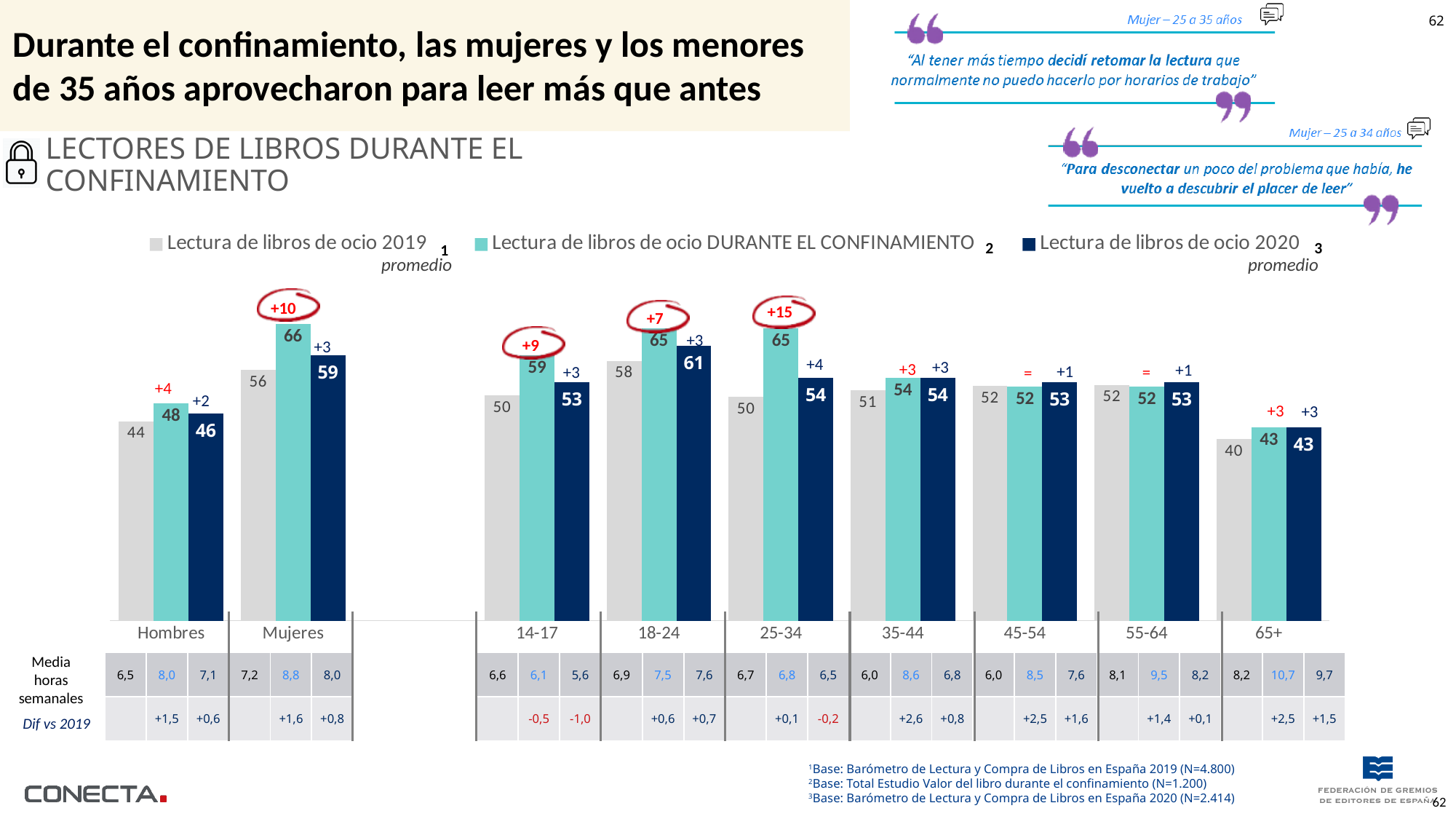
How many categories are shown on the x axis of the chart? 9 Which category has the lowest value in the 'Lectura de libros de ocio DURANTE EL CONFINAMIENTO' series? 65+ Which series in the legend is shown in dark blue? Lectura de libros de ocio 2020 What is the value for Hombres in the 'Lectura de libros de ocio 2019' series? 44 Which is larger: the 2020 value for Mujeres or the 2020 value for Hombres? Mujeres What is the value for Mujeres in the 'Lectura de libros de ocio DURANTE EL CONFINAMIENTO' series? 66 How many series does the chart legend list? 3 Which age group has the highest value in the 'Lectura de libros de ocio 2020' series? 18-24 What kind of chart is shown on the slide? bar chart What is the value for the 65+ group in the 'Lectura de libros de ocio 2019' series? 40 What is the difference between the 'DURANTE EL CONFINAMIENTO' value and the 2019 value for the 25-34 group? 15 What is the value for the 18-24 group in the 'Lectura de libros de ocio 2020' series? 61